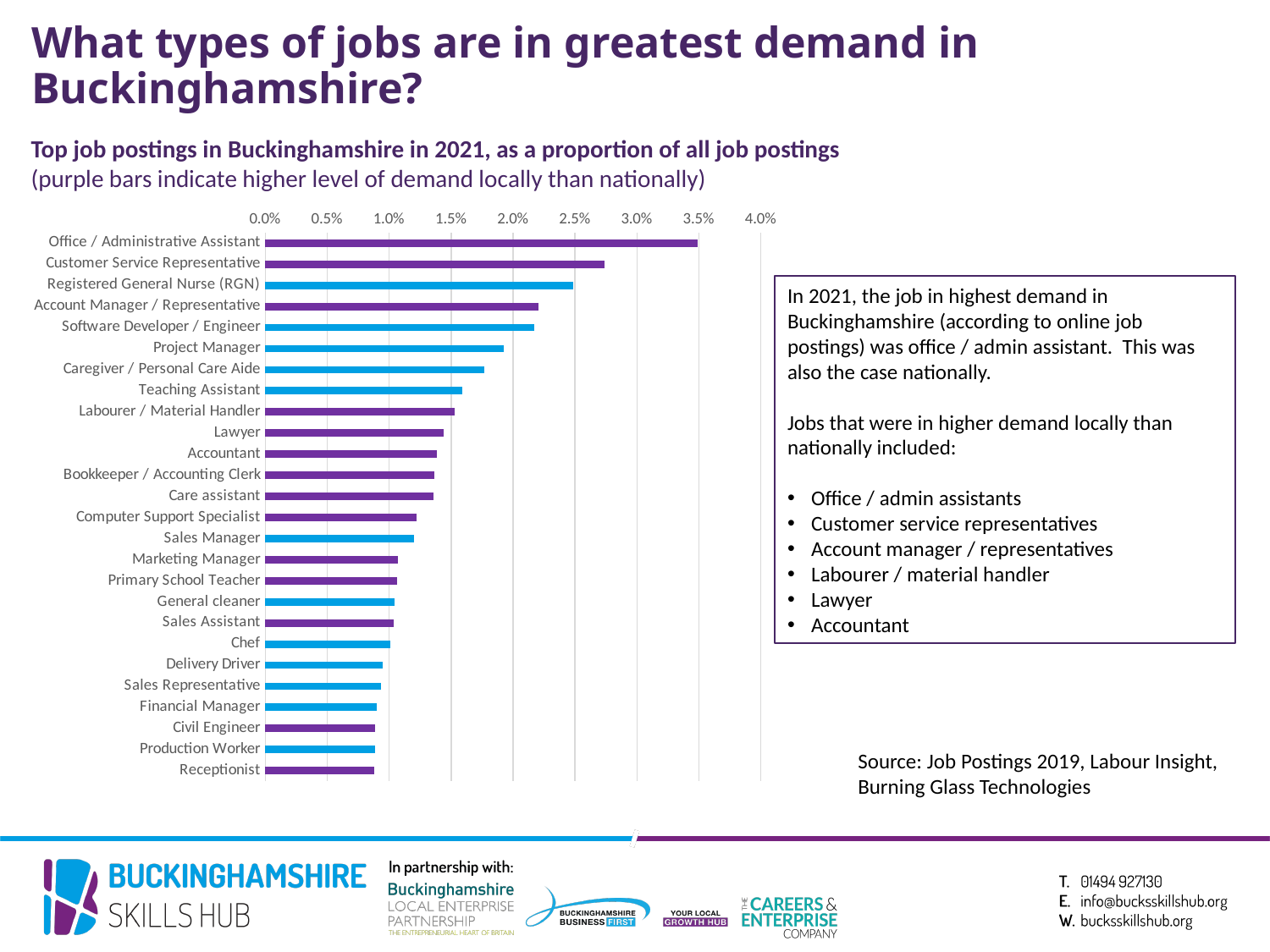
Is the value for Receptionist greater or less than 1.0%? less Which has a larger proportion of job postings, Office / Administrative Assistant or Customer Service Representative? Office / Administrative Assistant According to the chart subtitle, what do the purple bars indicate? Higher level of demand locally than nationally Is the value for Office / Administrative Assistant greater or less than 3.0%? greater Which has a larger proportion of job postings, Project Manager or Sales Manager? Project Manager Is the value for Account Manager / Representative greater or less than 2.0%? greater What kind of chart is shown on the slide? bar chart How many job categories are plotted in the chart? 26 Which job has the highest proportion of job postings in the chart? Office / Administrative Assistant